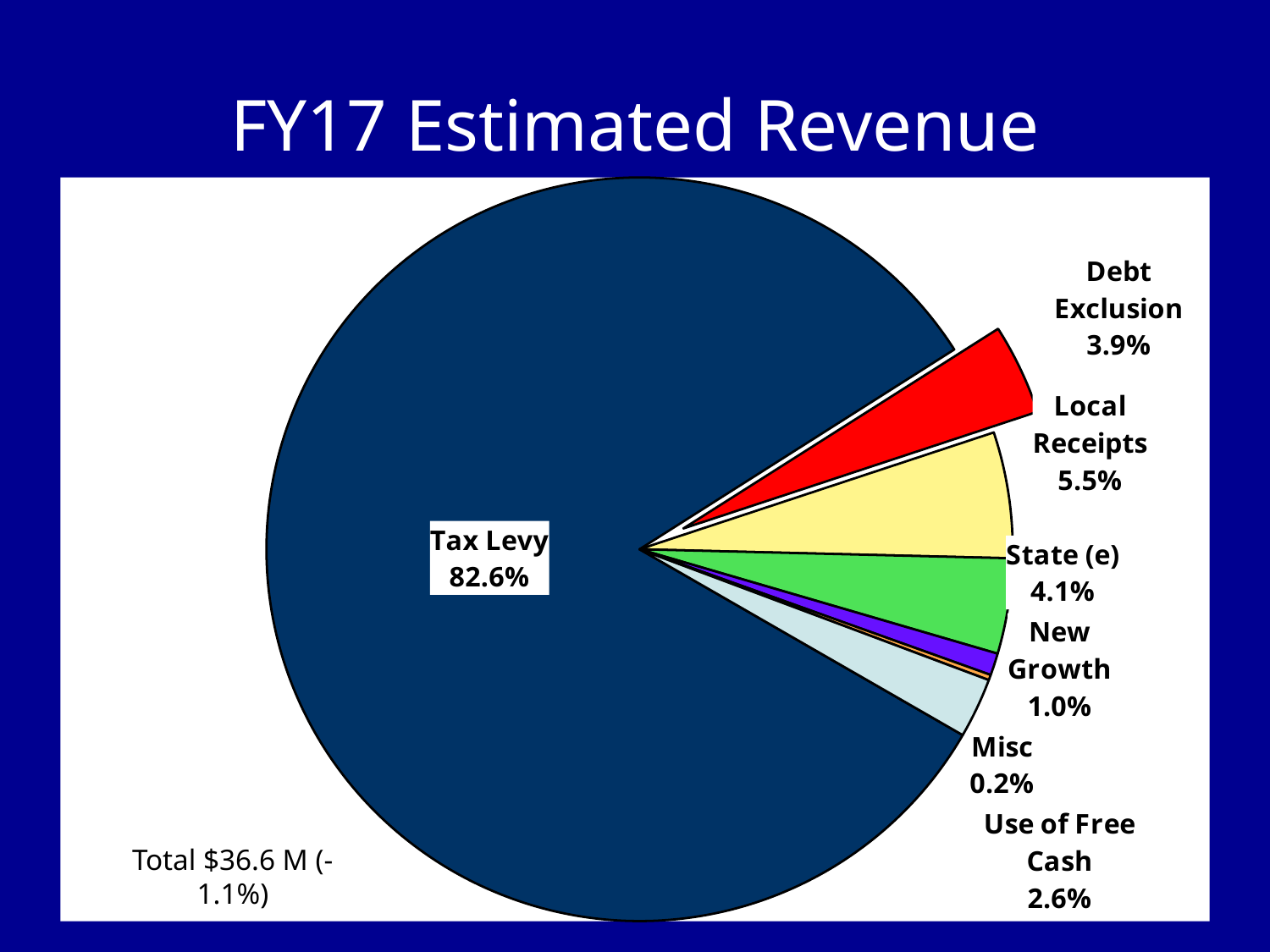
Which is larger, Local Receipts or State (e)? Local Receipts What total revenue amount is stated on the slide? $36.6 M What percentage of revenue is Debt Exclusion? 3.9% What is the difference in percentage points between Local Receipts and Debt Exclusion? 1.6 What share of FY17 estimated revenue comes from the Tax Levy? 82.6% What percentage of revenue is State (e)? 4.1% What percentage of revenue is Local Receipts? 5.5% What kind of chart is shown on the slide? Pie chart Which revenue source has the smallest share of the pie? Misc Which revenue source has the largest share of the pie? Tax Levy What percentage of revenue is Use of Free Cash? 2.6% How many slices does the pie chart have? 7